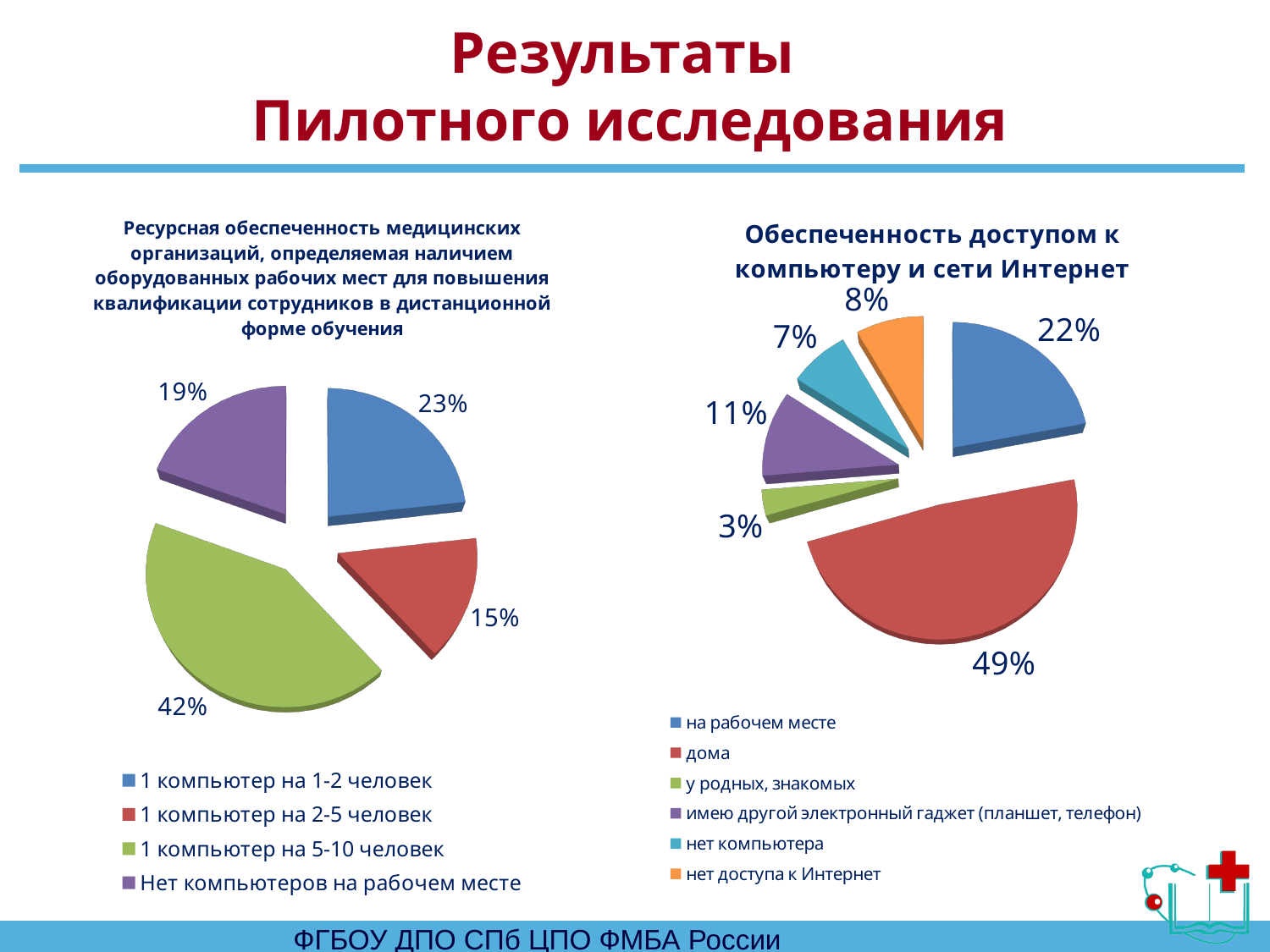
How many entries does the legend of the right pie chart (Обеспеченность доступом к компьютеру и сети Интернет) list? 6 In the left pie chart (Ресурсная обеспеченность медицинских организаций...), which category has the largest share? 1 компьютер на 5-10 человек In the right pie chart (Обеспеченность доступом к компьютеру и сети Интернет), what share is shown for 'дома'? 49% In the left pie chart (Ресурсная обеспеченность медицинских организаций...), what share is shown for '1 компьютер на 5-10 человек'? 42% In the right pie chart (Обеспеченность доступом к компьютеру и сети Интернет), which is larger: 'на рабочем месте' or 'имею другой электронный гаджет (планшет, телефон)'? на рабочем месте How many slices does the left pie chart (Ресурсная обеспеченность медицинских организаций...) have? 4 What type of chart is used on the right side of the slide (Обеспеченность доступом к компьютеру и сети Интернет)? Pie chart In the left pie chart (Ресурсная обеспеченность медицинских организаций...), what is the difference in percentage points between '1 компьютер на 1-2 человек' and '1 компьютер на 2-5 человек'? 8 In the left pie chart (Ресурсная обеспеченность медицинских организаций...), which category has the smallest share? 1 компьютер на 2-5 человек In the right pie chart (Обеспеченность доступом к компьютеру и сети Интернет), what share is shown for 'нет компьютера'? 7% In the right pie chart (Обеспеченность доступом к компьютеру и сети Интернет), which category has the smallest share? у родных, знакомых In the left pie chart (Ресурсная обеспеченность медицинских организаций...), what share is shown for 'Нет компьютеров на рабочем месте'? 19%